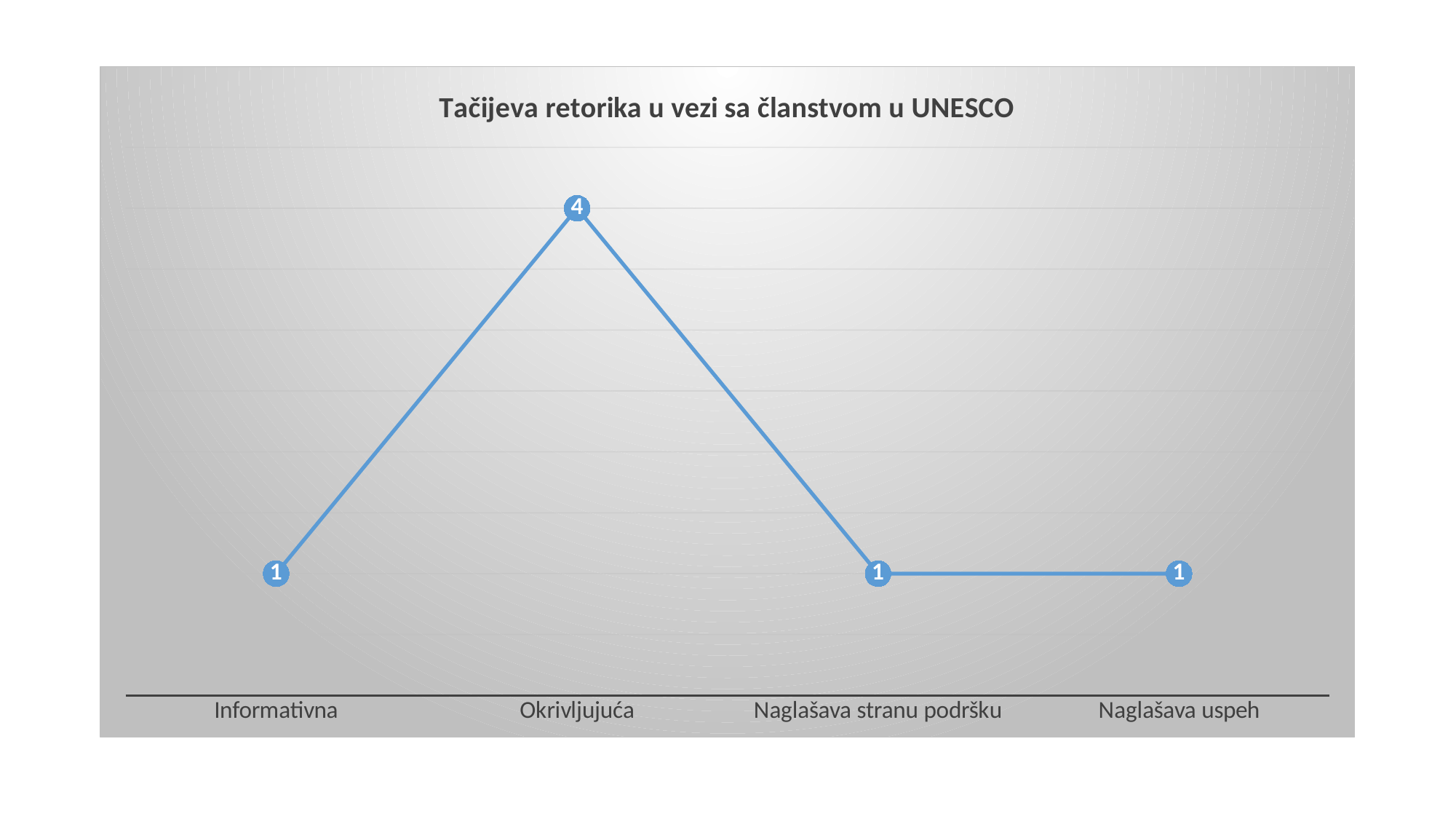
How many categories are shown on the x axis? 4 What is the value for Okrivljujuća? 4 Does the value rise or fall from Okrivljujuća to Naglašava stranu podršku? Fall What is the title of the chart? Tačijeva retorika u vezi sa članstvom u UNESCO What is the value for Naglašava uspeh? 1 What is the value for Naglašava stranu podršku? 1 What kind of chart is shown on the slide? Line chart Which is larger, the value for Okrivljujuća or the value for Naglašava uspeh? Okrivljujuća What is the value for Informativna? 1 What is the difference between the values for Okrivljujuća and Informativna? 3 What is the total of all four plotted values? 7 Which category has the highest value? Okrivljujuća